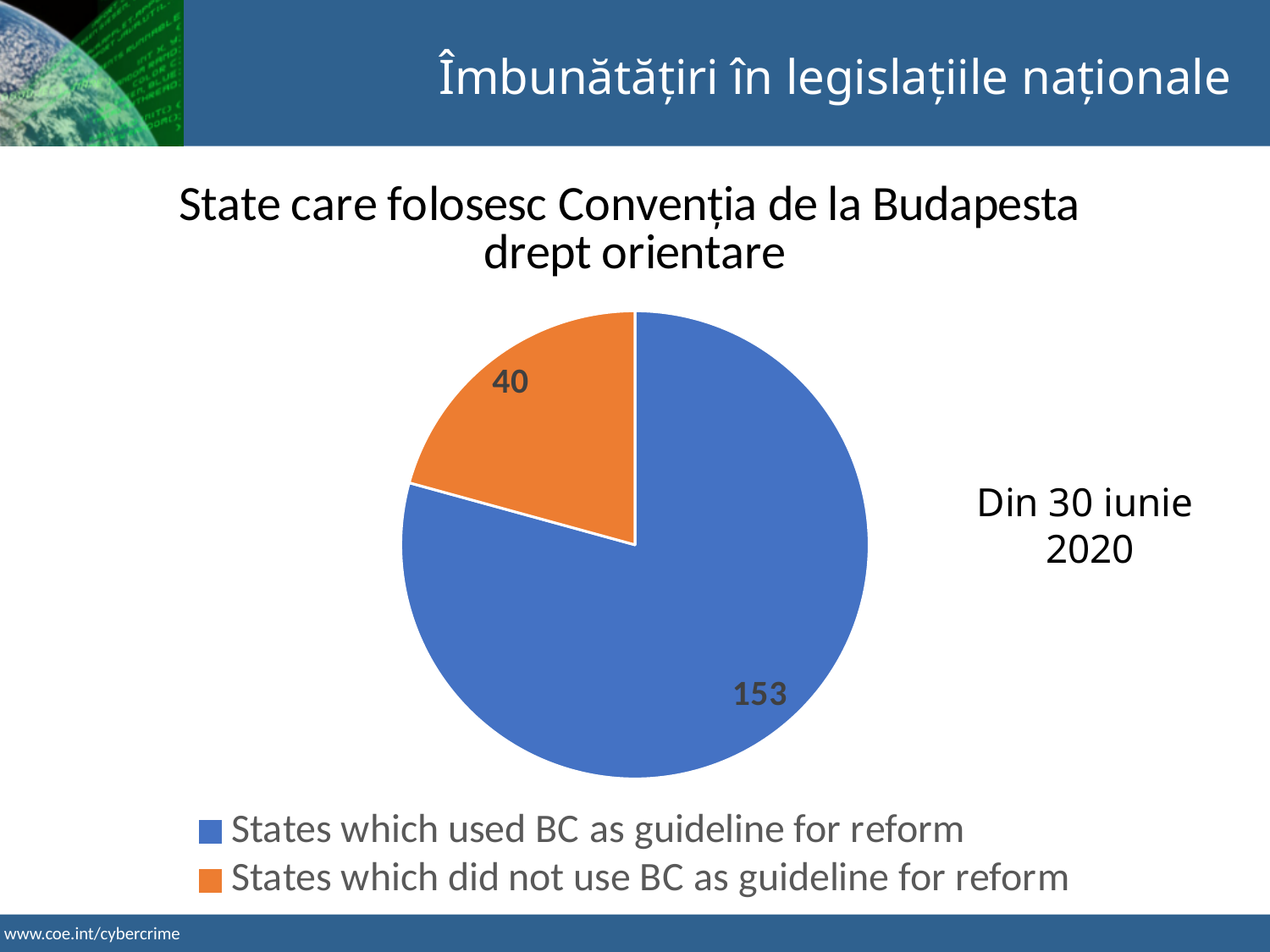
How many entries does the legend list? 2 What is the difference between the number of states which used BC as guideline for reform and those which did not? 113 Which colour represents states which did not use BC as guideline for reform? orange Which category has the smaller slice of the pie? States which did not use BC as guideline for reform How many states did not use BC as a guideline for reform? 40 Is the value for states which used BC as guideline for reform larger or smaller than the value for states which did not? larger How many slices does the pie chart have? 2 What is the title of the chart? State care folosesc Convenția de la Budapesta drept orientare How many states used the Budapest Convention (BC) as a guideline for reform? 153 Which category has the larger slice of the pie? States which used BC as guideline for reform What is the total number of states represented in the pie chart? 193 What kind of chart is shown on the slide? pie chart